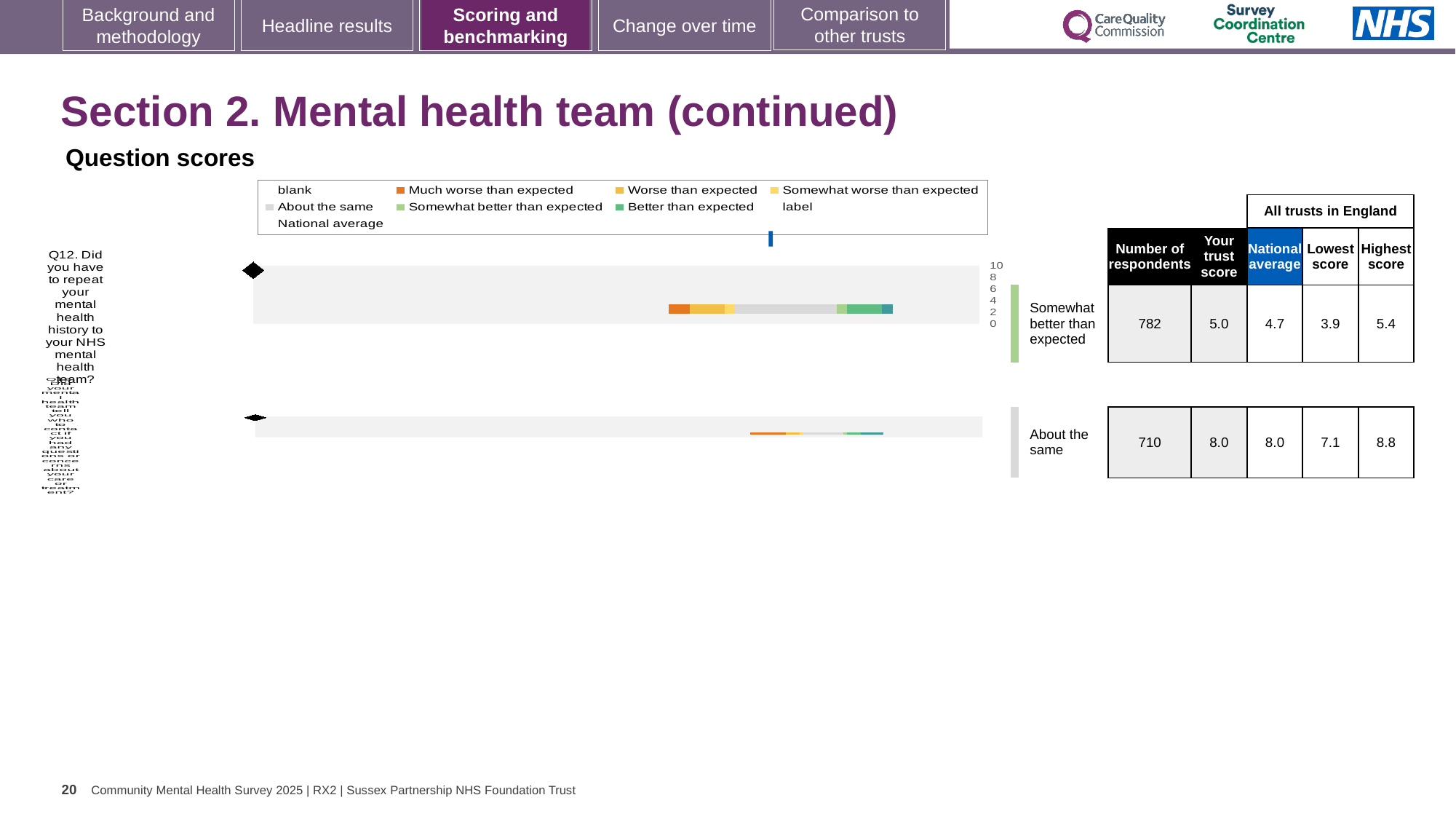
Which benchmark category is Q12 placed in, according to the label to the right of the chart? Somewhat better than expected What kind of chart is used to show the question scores on this slide? bar chart How many questions (rows) are plotted in the question scores chart? 2 What is the national average for Q12 in the table? 4.7 In the table next to the chart, what is the number of respondents for Q12 (repeating your mental health history)? 782 What colour does the legend use for 'Much worse than expected'? Orange For Q12, what is the difference between the highest score and the lowest score across all trusts in England? 1.5 Which benchmark category is the second (lower) question row placed in? About the same What is 'Your trust score' for Q12 in the table? 5.0 For Q12, which is larger: your trust score or the national average? Your trust score What is the number of respondents for the second (lower) question row in the table? 710 What is the highest score across all trusts in England for Q12? 5.4